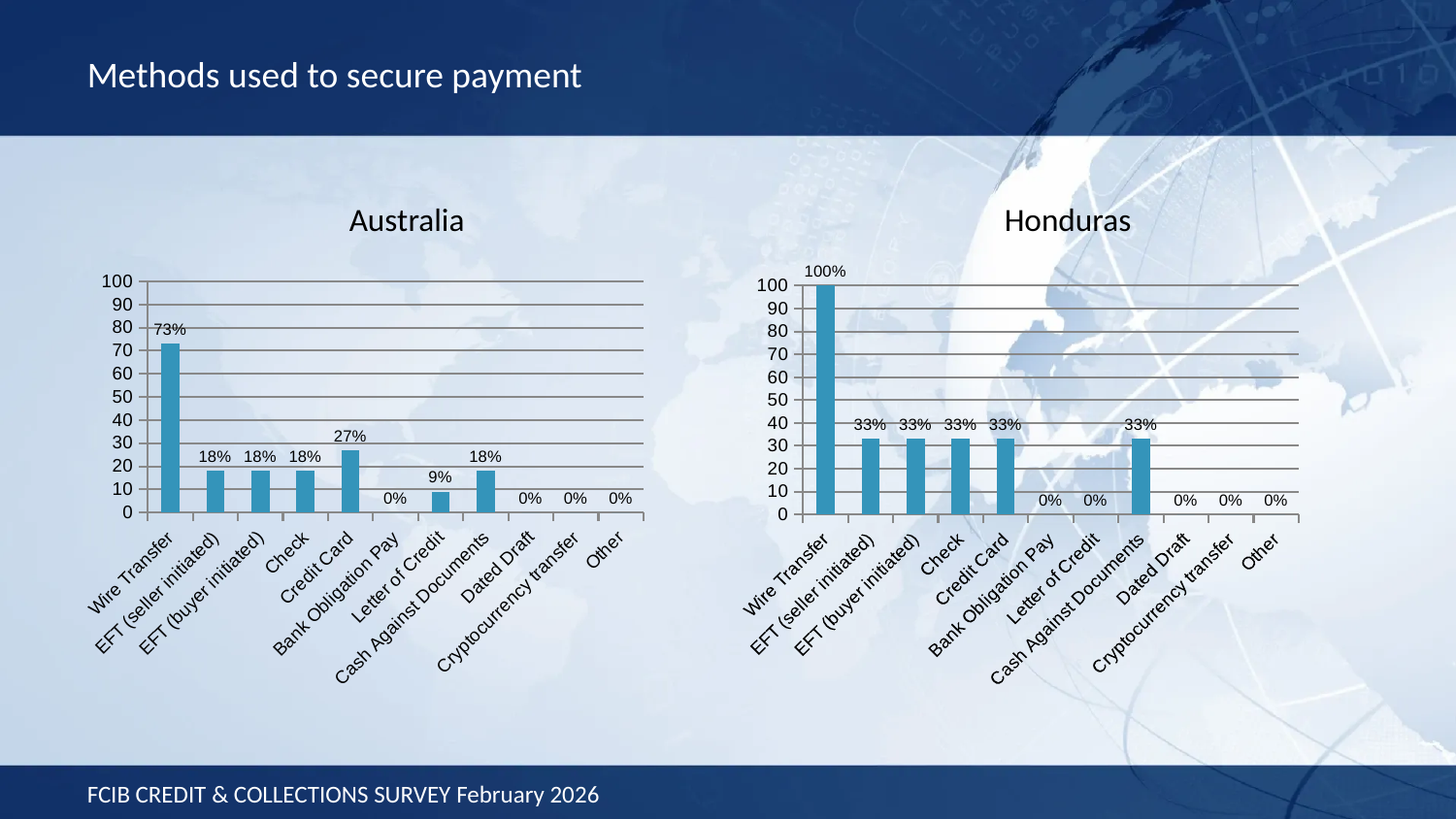
In the Australia chart, which is larger, Credit Card or Letter of Credit? Credit Card In the Honduras chart, what is the value for Cash Against Documents? 33% In the Australia chart, which category has the highest value? Wire Transfer How many categories are shown on the x axis of the Honduras chart? 11 In the Australia chart, what is the value for Credit Card? 27% In the Honduras chart, what is the value for Letter of Credit? 0% In the Australia chart, what is the value for Wire Transfer? 73% In the Honduras chart, what is the difference between Wire Transfer and Check? 67% In the Honduras chart, what is the value for Wire Transfer? 100% In the Australia chart, what is the value for Letter of Credit? 9% In the Australia chart, what is the difference between Wire Transfer and Credit Card? 46% What kind of chart is the Australia chart? Bar chart